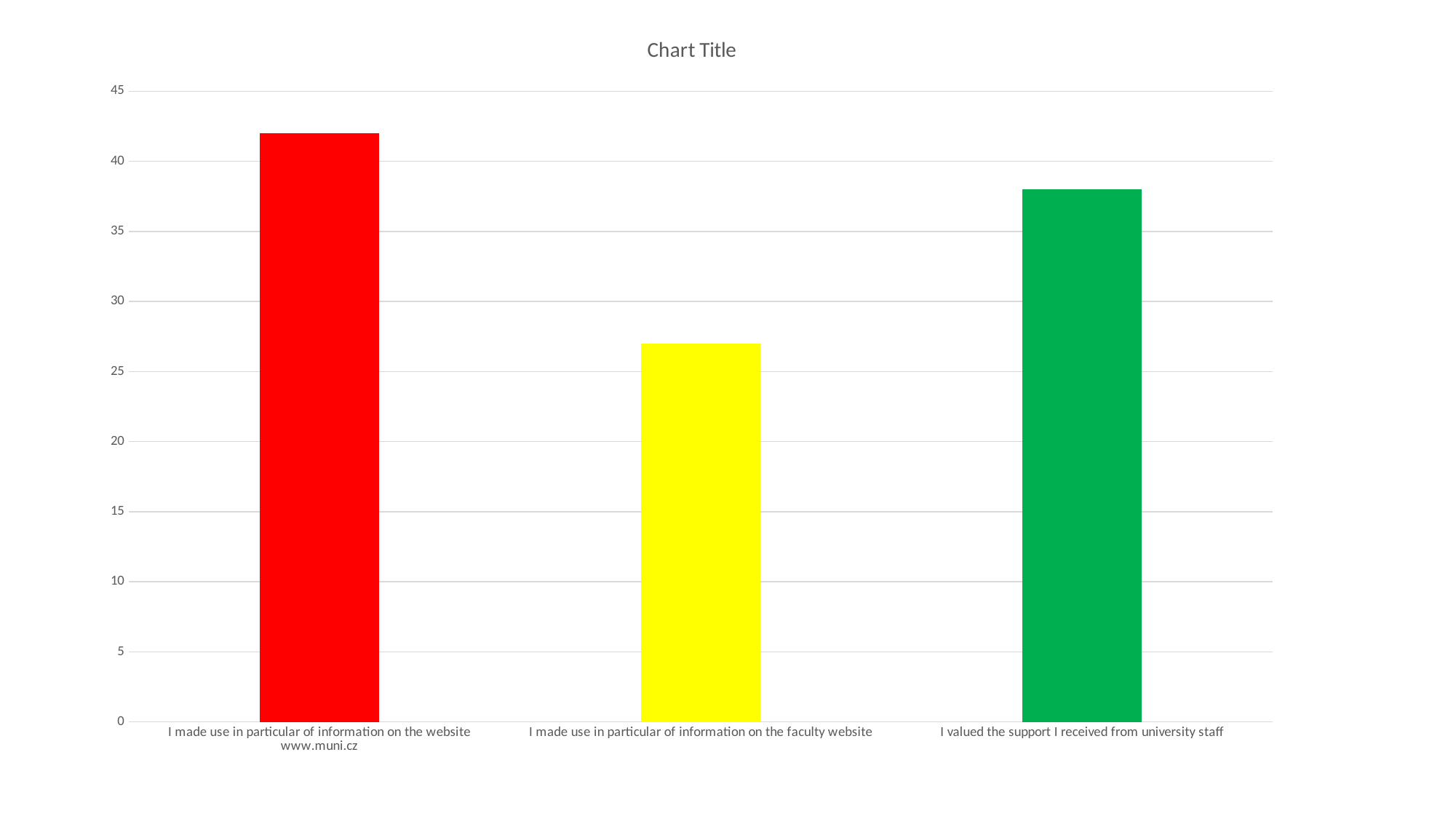
Which category has the lowest value? I made use in particular of information on the faculty website Is the value for "I made use in particular of information on the faculty website" greater or less than 25? greater Which category has the highest value? I made use in particular of information on the website www.muni.cz What is the title of the chart? Chart Title Is the value for "I made use in particular of information on the faculty website" greater or less than 30? less What kind of chart is shown on the slide? bar chart What colour is the bar for "I valued the support I received from university staff"? green Which is larger: the value for "I valued the support I received from university staff" or the value for "I made use in particular of information on the faculty website"? I valued the support I received from university staff Is the value for "I valued the support I received from university staff" greater or less than 35? greater How many categories are plotted in the chart? 3